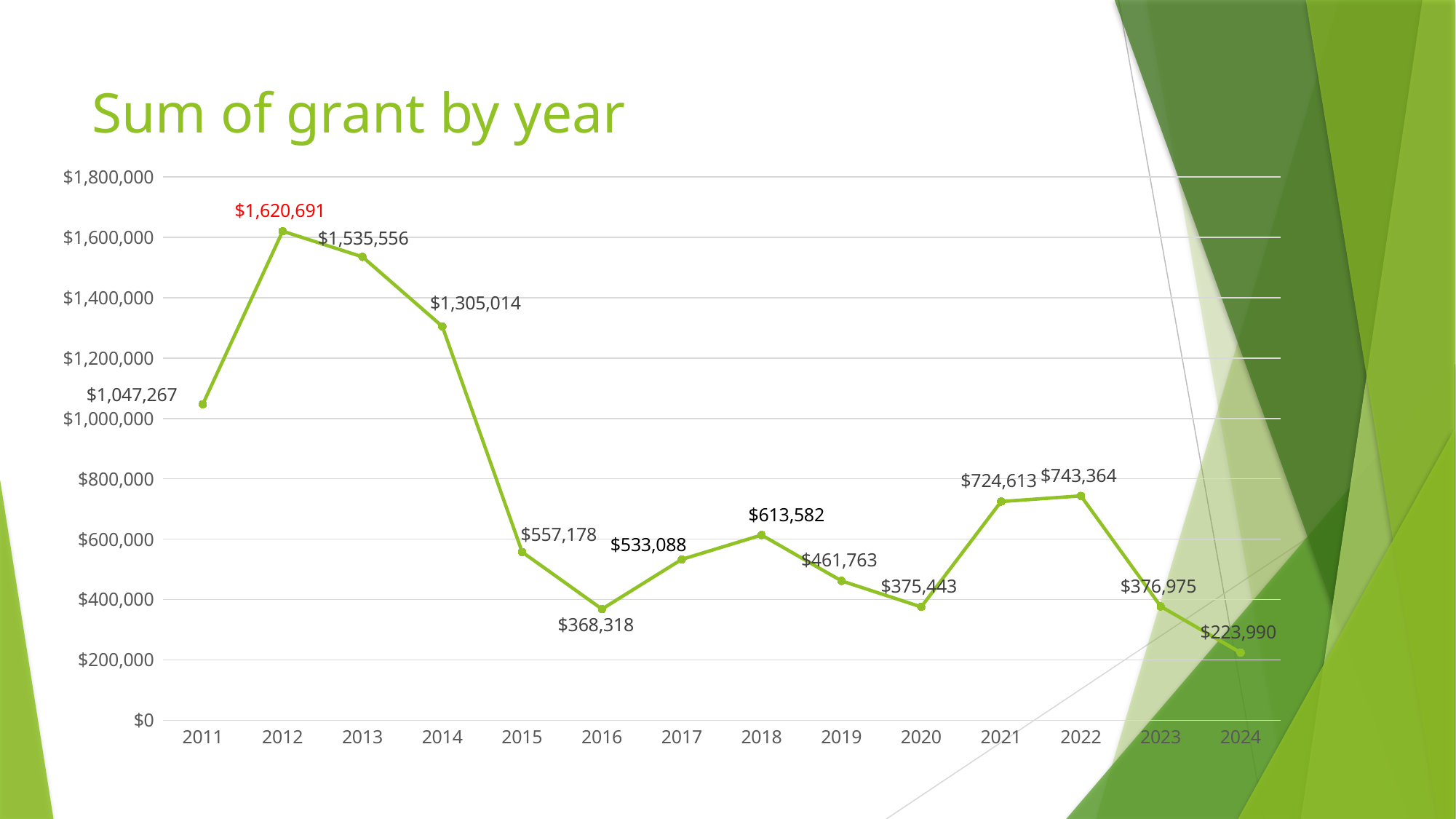
What is the difference between the sum of grant in 2012 and in 2013? $85,135 Is the value for 2014 greater or less than $1,200,000? greater Which year has a larger sum of grant, 2018 or 2019? 2018 What is the sum of grant for 2024? $223,990 Which year has the highest sum of grant? 2012 What kind of chart is shown on the slide? line chart How many years are plotted on the chart? 14 What is the sum of grant for 2012? $1,620,691 What is the sum of grant for 2016? $368,318 What is the difference between the sum of grant in 2022 and in 2021? $18,751 Do the values rise or fall from 2014 to 2016? fall Which year has the lowest sum of grant? 2024